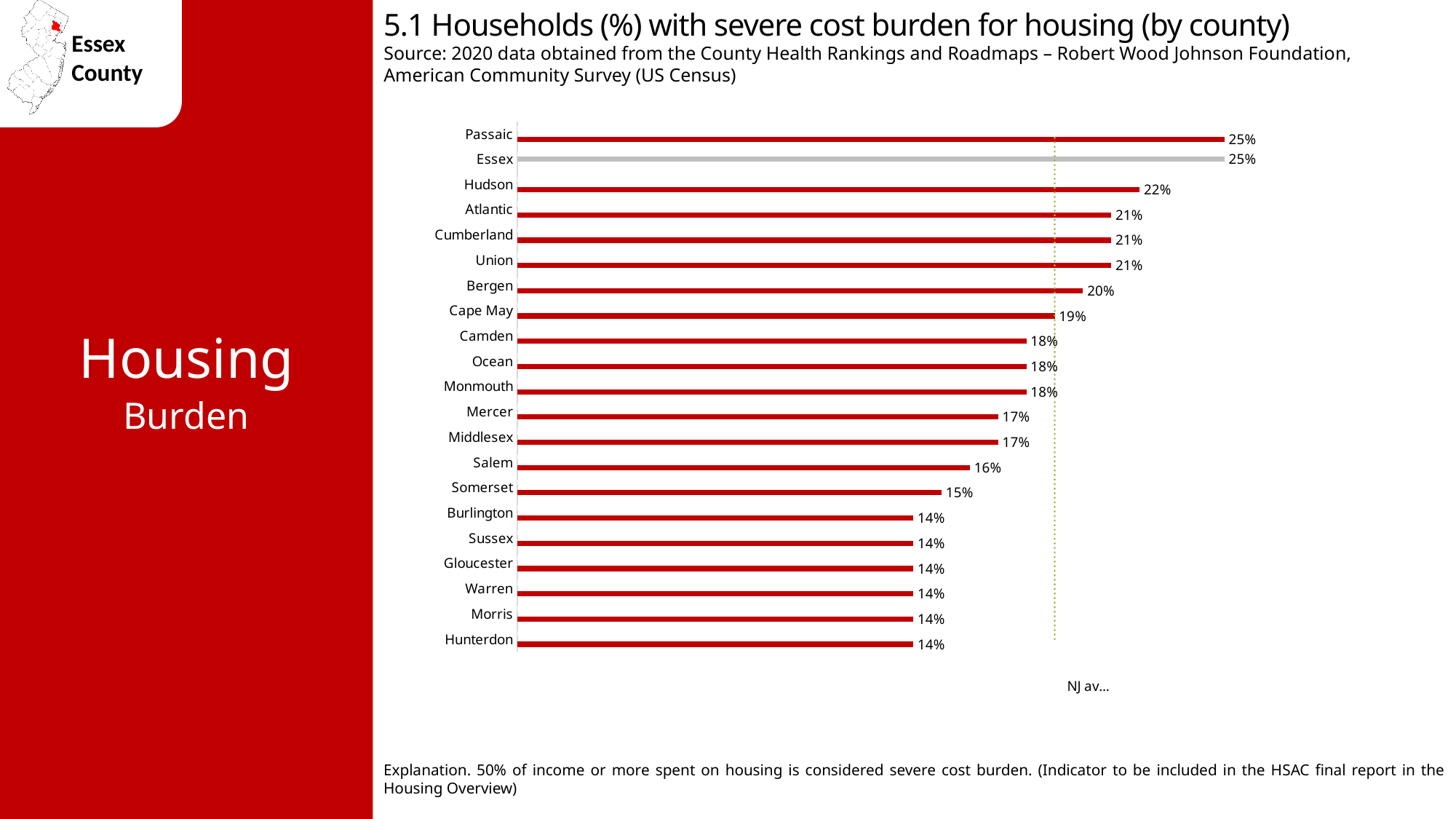
How many counties are plotted on the chart? 21 What is the value for Bergen? 20% What is the value for Somerset? 15% Which county's bar is shown in grey rather than red? Essex What is the difference between the values for Hudson and Salem? 6% Which is larger, the value for Somerset or the value for Atlantic? Atlantic What is the value for Hudson? 22% Which county has the lowest value shown at the bottom of the chart? Hunterdon Which is larger, the value for Cape May or the value for Mercer? Cape May What is the difference between the values for Passaic and Hunterdon? 11% What is the value for Essex? 25% What kind of chart is shown on the slide? Bar chart